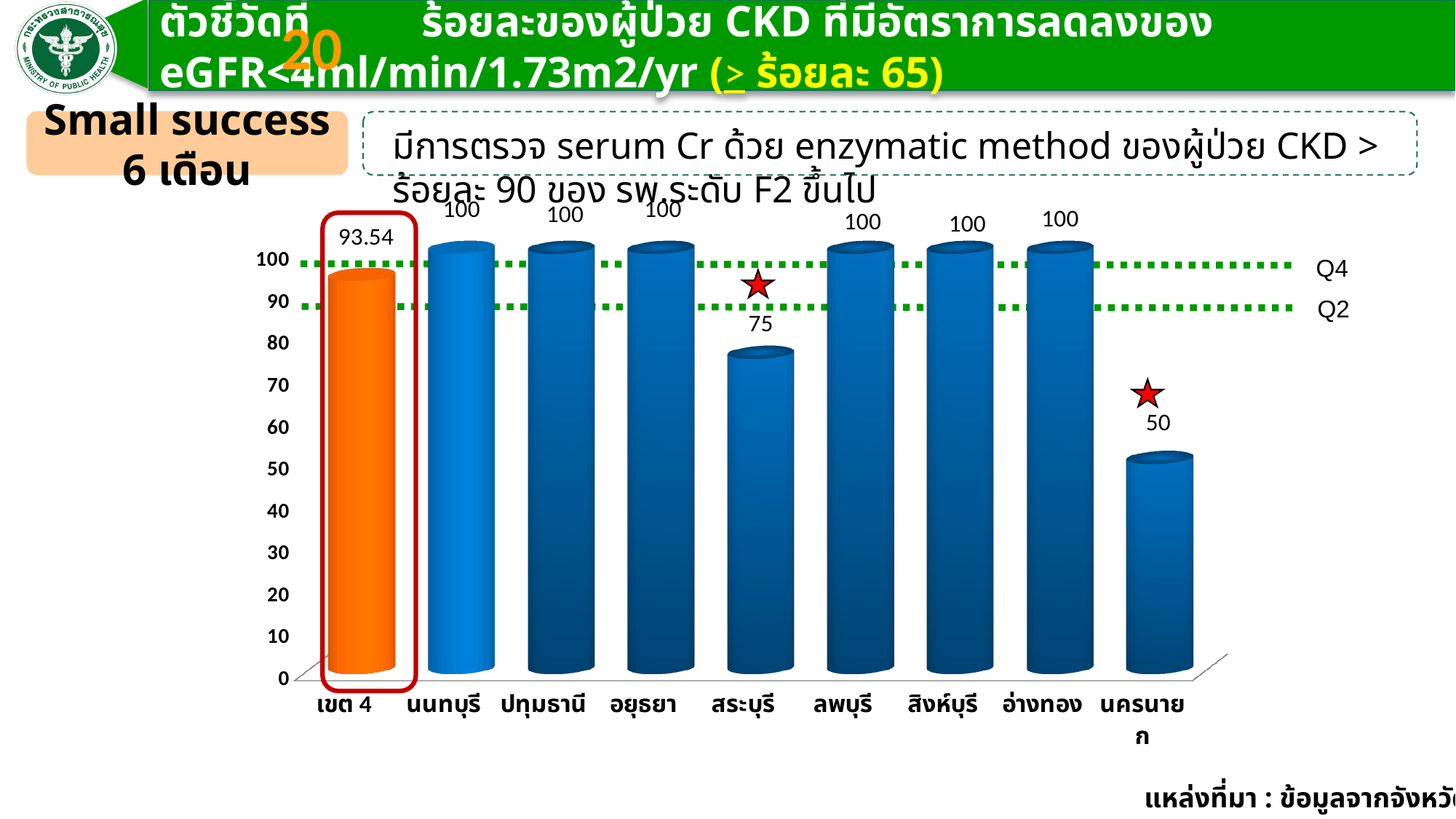
What is the difference between the values for นนทบุรี and เขต 4? 6.46 What is the difference between the values for สระบุรี and นครนายก? 25 How many categories are shown on the x axis? 9 Which category has the lowest value? นครนายก What kind of chart is shown on the slide? bar chart What is the value for สระบุรี? 75 What is the value for นครนายก? 50 Is the value for เขต 4 greater or less than 90? greater What is the value for ลพบุรี? 100 Which bar is coloured orange? เขต 4 Which is larger, the value for สระบุรี or the value for นครนายก? สระบุรี What is the value for เขต 4? 93.54